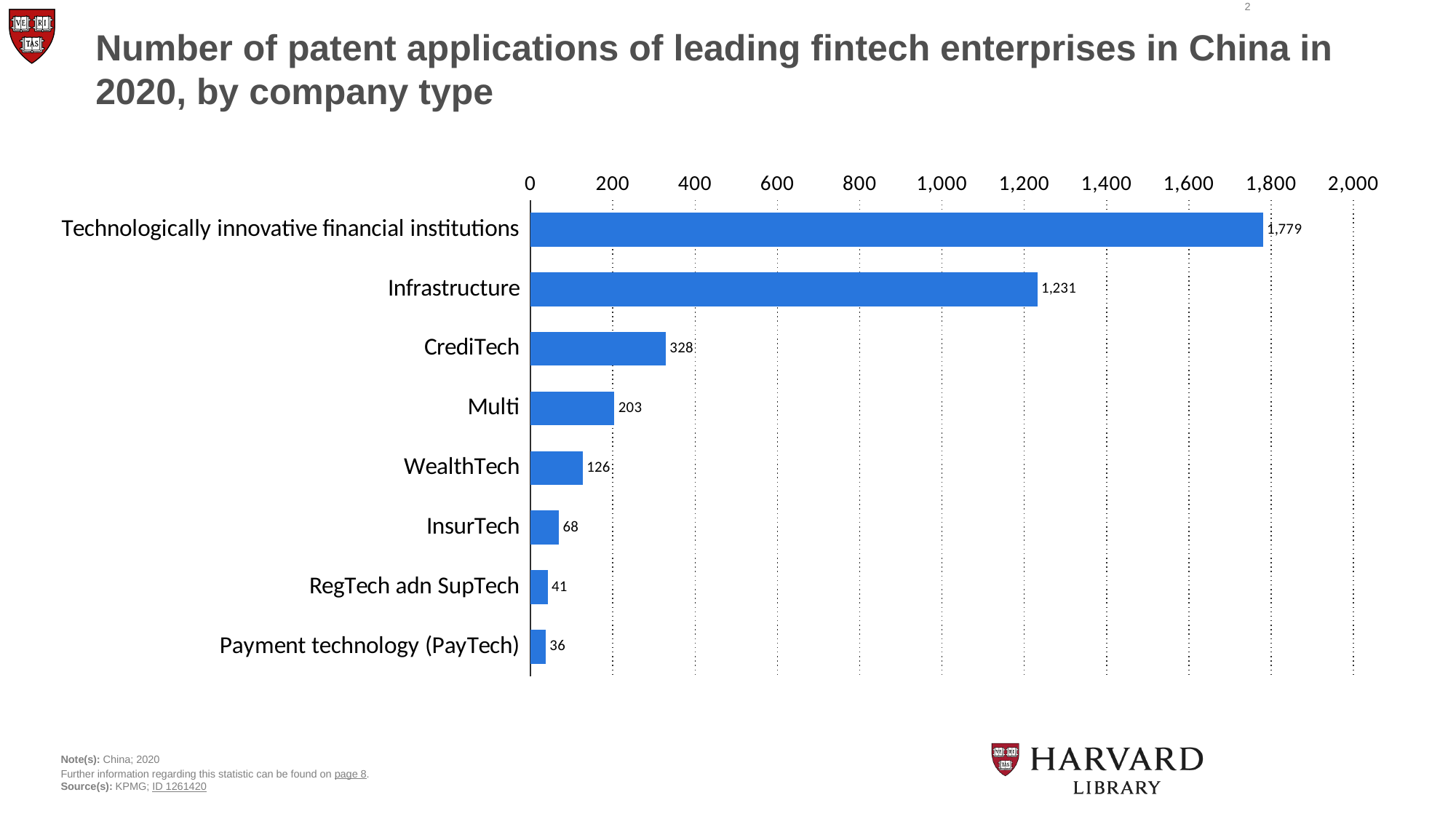
Which company type has the highest number of patent applications? Technologically innovative financial institutions What kind of chart is shown on the slide? bar chart What is the maximum value shown on the horizontal axis? 2,000 Which has a larger value, Multi or WealthTech? Multi Which company type has the lowest number of patent applications? Payment technology (PayTech) What is the value shown for CrediTech? 328 How many patent applications did Infrastructure companies file? 1,231 Is the value for CrediTech greater or less than 400? less What is the difference between the values for InsurTech and RegTech adn SupTech? 27 What is the difference between the values for Technologically innovative financial institutions and Infrastructure? 548 What is the number of patent applications for WealthTech? 126 How many company types are shown in the chart? 8